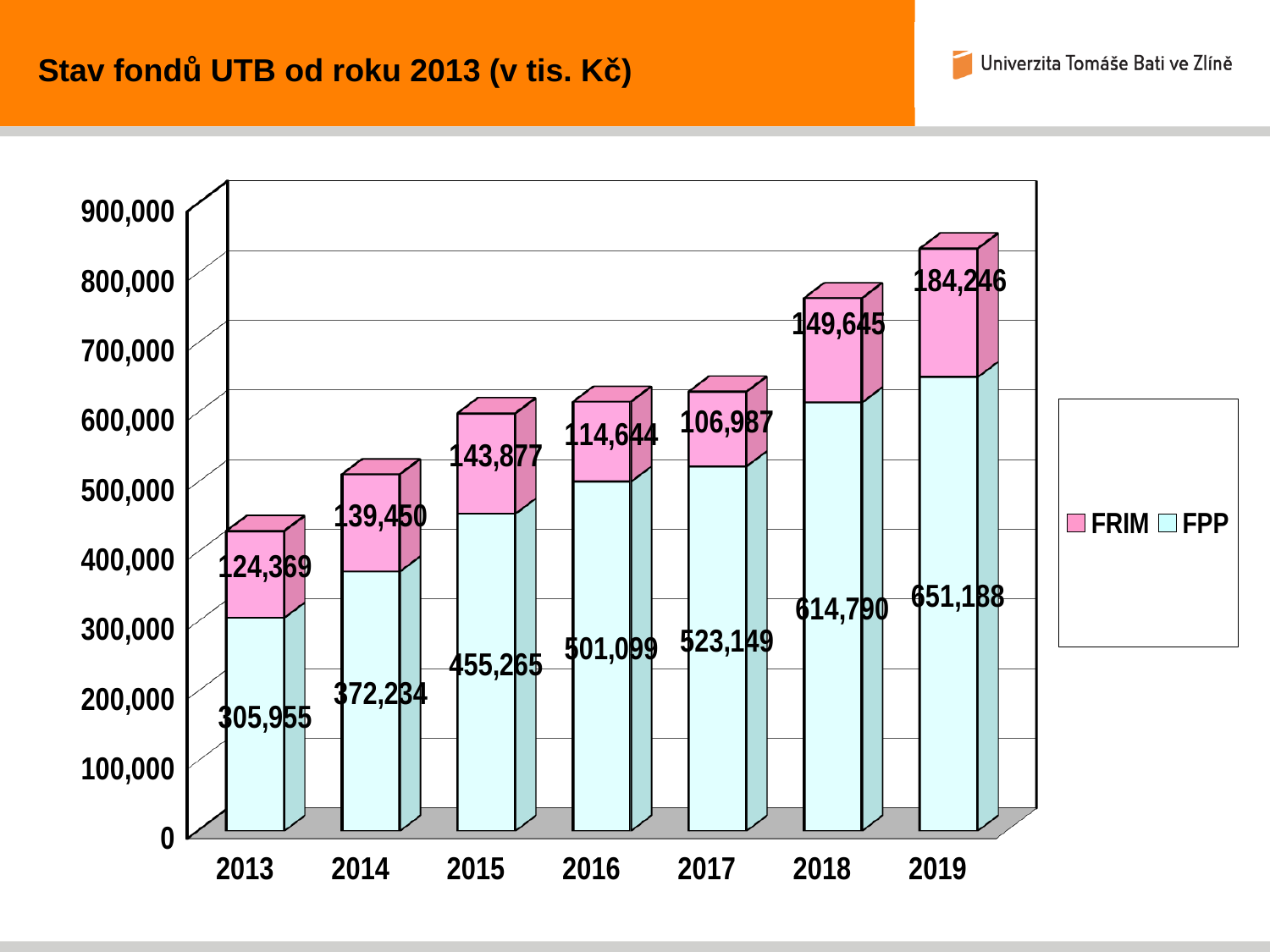
What is the total of the stacked bar for 2019? 835,434 Which year has the lowest FRIM value? 2017 What kind of chart is shown on the slide? Stacked bar chart What is the FPP value for 2019? 651,188 What is the FRIM value for 2016? 114,644 How many years are shown on the x axis? 7 Which year has the highest FRIM value? 2019 How many series does the legend list? 2 Which is larger, the FRIM value for 2015 or the FRIM value for 2014? 2015 What is the FPP value for 2013? 305,955 Do the FPP values rise or fall from 2013 to 2019? Rise What is the difference between the FPP values for 2019 and 2013? 345,233